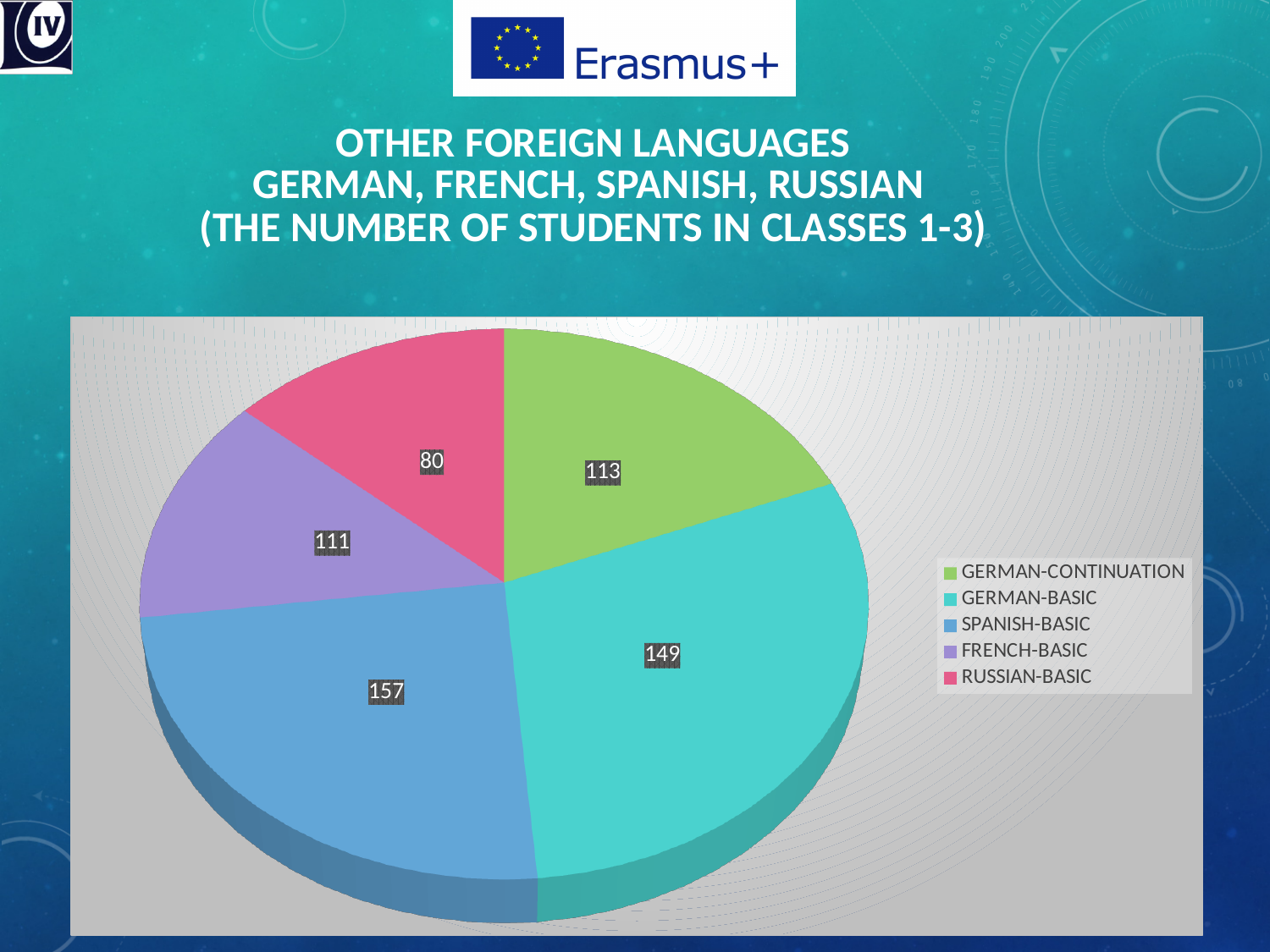
What is the total number of students across all slices of the pie chart? 610 Which is larger, the value for GERMAN-BASIC or the value for FRENCH-BASIC? GERMAN-BASIC What is the number of students for RUSSIAN-BASIC? 80 What is the difference between the values for SPANISH-BASIC and GERMAN-BASIC? 8 What is the number of students for GERMAN-CONTINUATION? 113 Which colour represents RUSSIAN-BASIC in the pie chart? pink What is the number of students for SPANISH-BASIC? 157 How many slices does the pie chart have? 5 How many entries does the legend list? 5 Which category has the smallest number of students? RUSSIAN-BASIC Which category has the largest number of students? SPANISH-BASIC What kind of chart is shown on the slide? pie chart